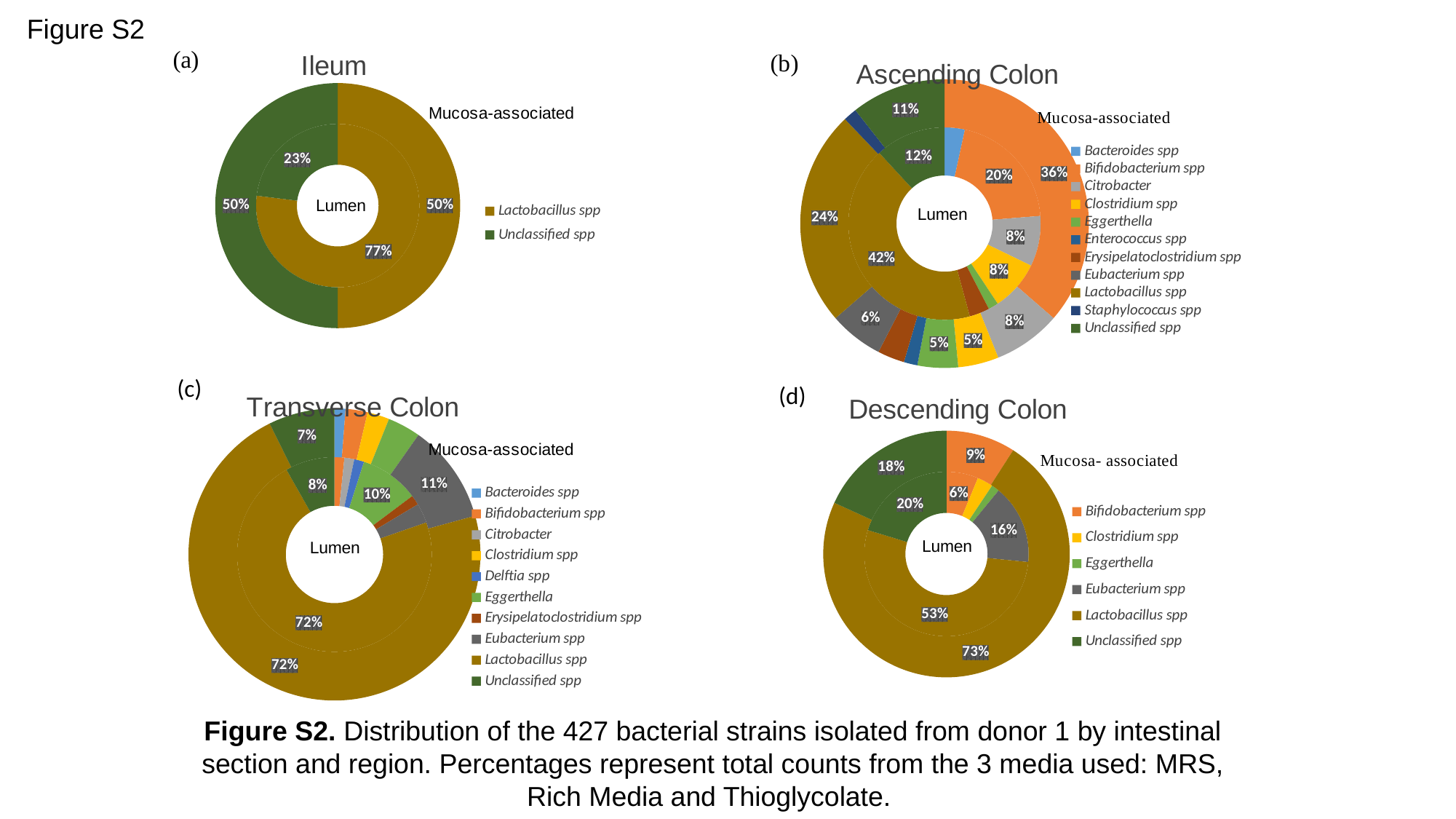
In the Descending Colon chart, what percentage of the Mucosa-associated ring is Lactobacillus spp? 73% In the Ileum chart, what percentage of the Lumen ring is Lactobacillus spp? 77% In the Transverse Colon chart, what percentage of the Lumen ring is Lactobacillus spp? 72% In the Ileum chart, what is the difference between the Lactobacillus spp and Unclassified spp shares in the Lumen ring? 54 percentage points In the Ileum chart, what percentage of the Mucosa-associated ring is Unclassified spp? 50% In the Ascending Colon chart, what percentage of the Mucosa-associated ring is Bifidobacterium spp? 36% In the Descending Colon chart, which has the larger share of the Lumen ring: Unclassified spp or Eubacterium spp? Unclassified spp In the Descending Colon chart, what percentage of the Lumen ring is Eubacterium spp? 16% How many entries does the legend of the Ascending Colon chart list? 11 In the Ascending Colon chart, what percentage of the Lumen ring is Lactobacillus spp? 42% How many entries does the legend of the Transverse Colon chart list? 10 What kind of chart is used for the Ileum panel? Doughnut (pie) chart